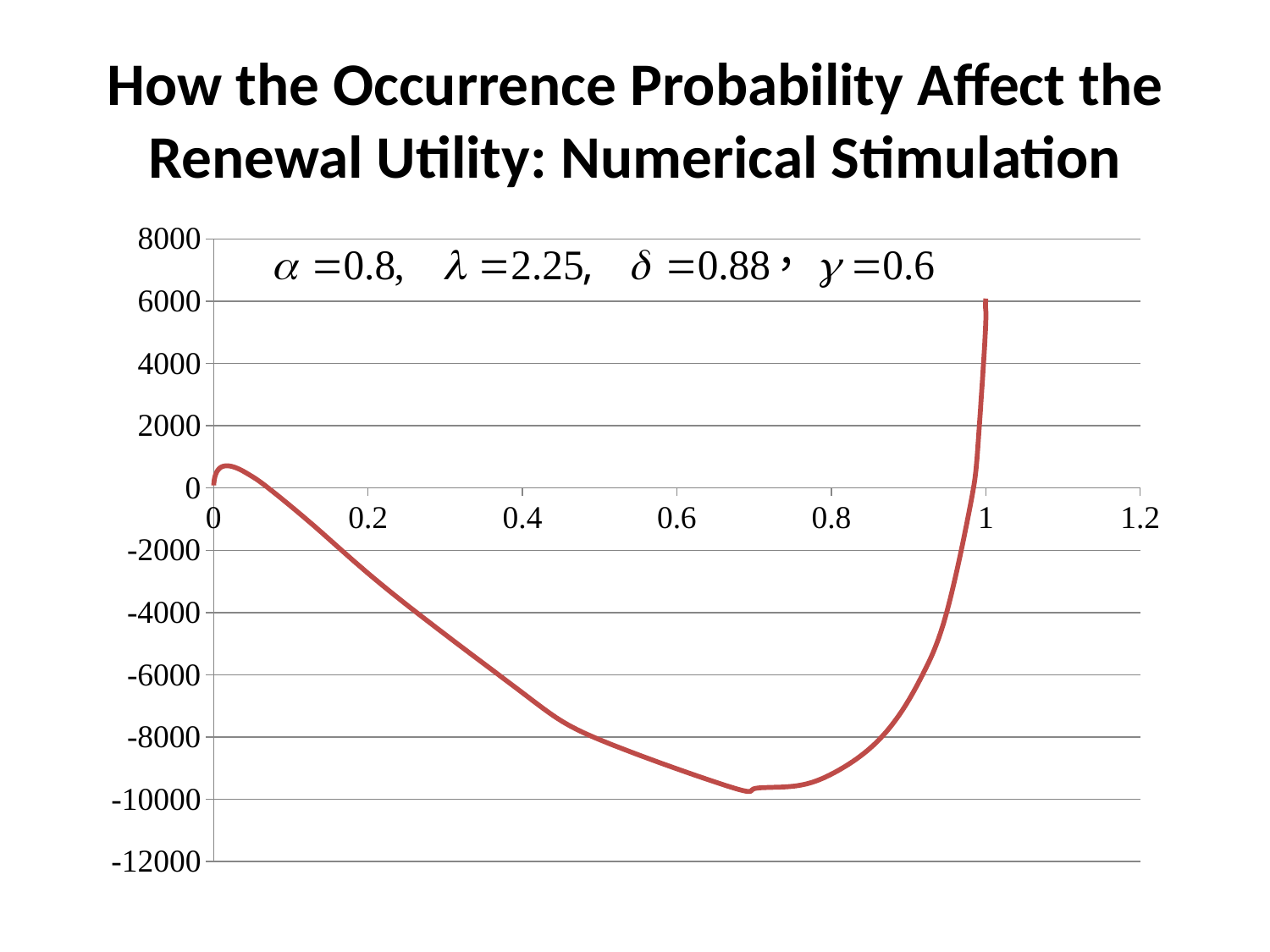
How many lines (series) are plotted on the chart? 1 Is the plotted value at x = 0.4 greater or less than -4000? less Is the lowest point of the curve greater or less than -8000? less Is the curve's value at x = 1 greater or less than 4000? greater What is the title of the slide's chart? How the Occurrence Probability Affect the Renewal Utility: Numerical Stimulation What kind of chart is shown on the slide? line chart Do the plotted values rise or fall as x increases from 0.8 to 1? rise Do the plotted values rise or fall as x increases from 0.2 to 0.6? fall What value of λ (lambda) is stated in the parameter annotation on the chart? 2.25